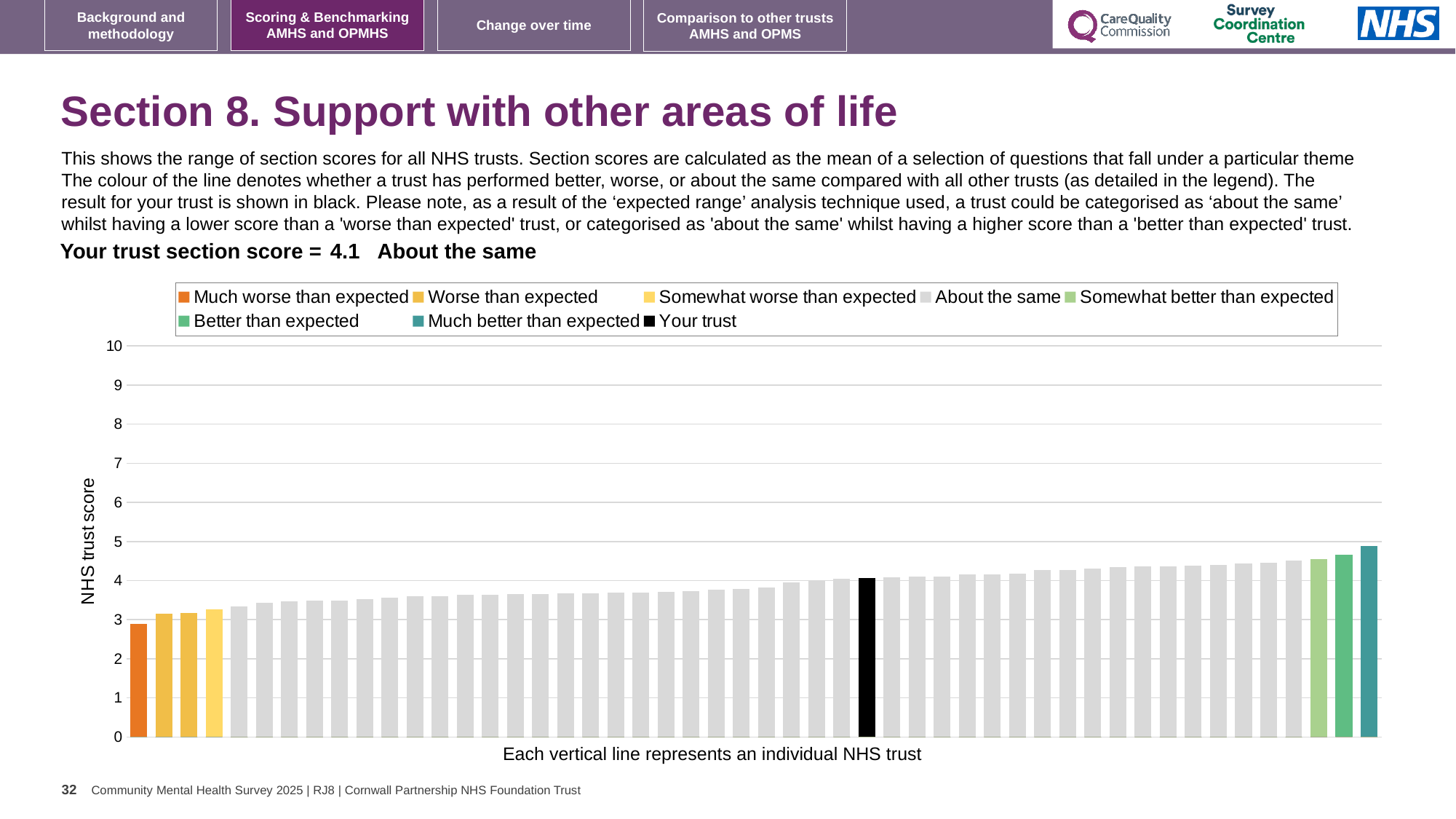
What colour is the bar representing your trust? black What is the section score for your trust shown on the slide? 4.1 Is the value of the tallest bar (far right) greater or less than 4? greater Do the bar values rise or fall from left to right along the x axis? rise What kind of chart is shown on the slide? bar chart Which legend category does the shortest bar on the chart belong to? Much worse than expected How many bars are coloured as 'Much worse than expected'? 1 How many entries does the chart legend list? 8 Is the value of the shortest bar (far left) greater or less than 4? less What is the label on the vertical axis of the chart? NHS trust score Which legend category does the tallest bar on the chart belong to? Much better than expected